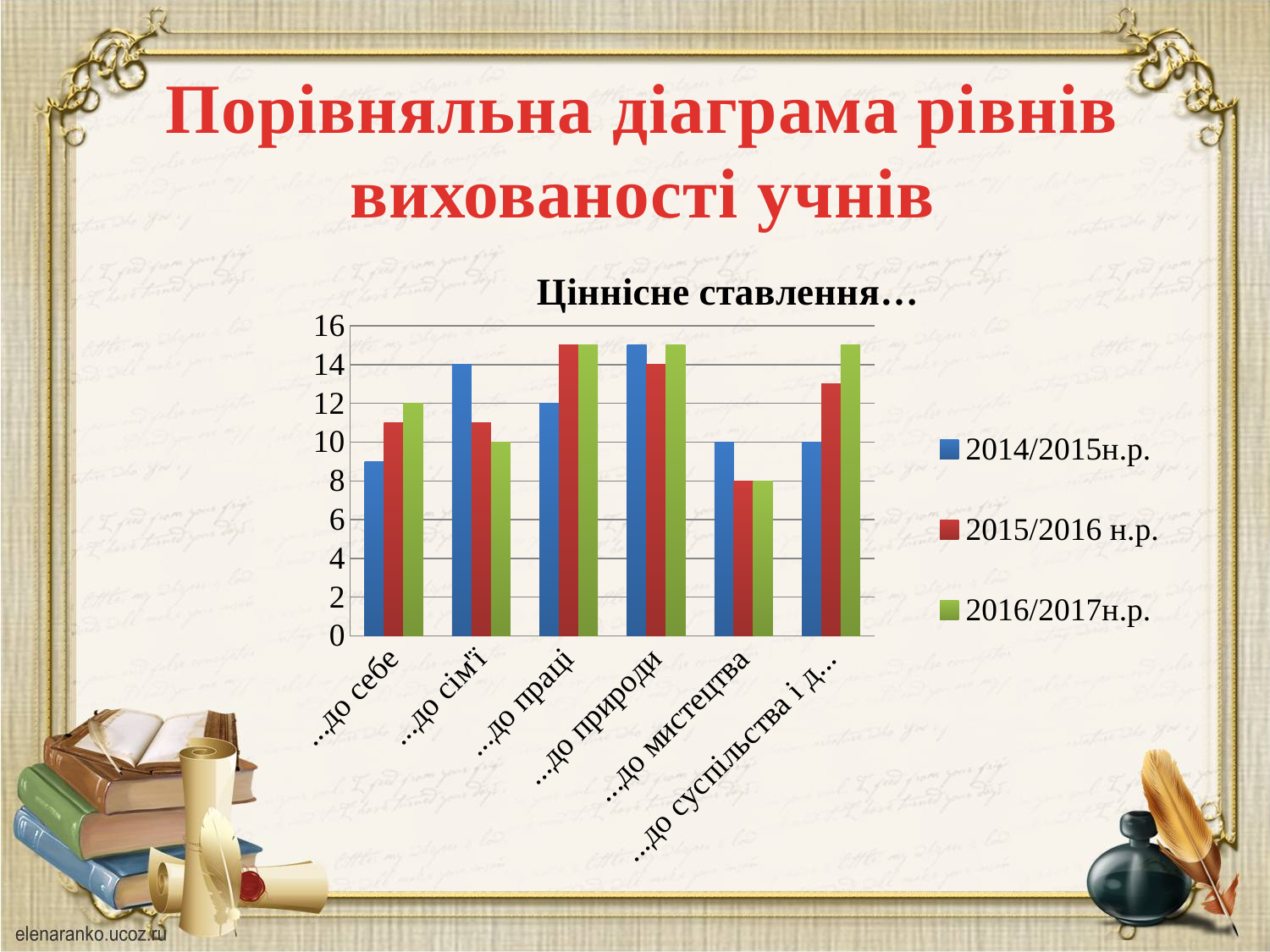
How many series does the legend list? 3 Which is larger for "…до сім'ї": the 2014/2015н.р. value or the 2016/2017н.р. value? 2014/2015н.р. What kind of chart is shown on the slide? bar chart What is the difference between the 2014/2015н.р. and 2015/2016 н.р. values for "…до мистецтва"? 2 What is the value for "…до сім'ї" in the 2014/2015н.р. series? 14 What is the value for "…до праці" in the 2014/2015н.р. series? 12 Which category has the lowest value in the 2016/2017н.р. series? …до мистецтва How many categories are shown on the x axis? 6 Is the value for "…до праці" in the 2016/2017н.р. series greater or less than 14? greater What is the value for "…до мистецтва" in the 2015/2016 н.р. series? 8 Is the value for "…до себе" in the 2014/2015н.р. series greater or less than 10? less What is the value for "…до себе" in the 2016/2017н.р. series? 12